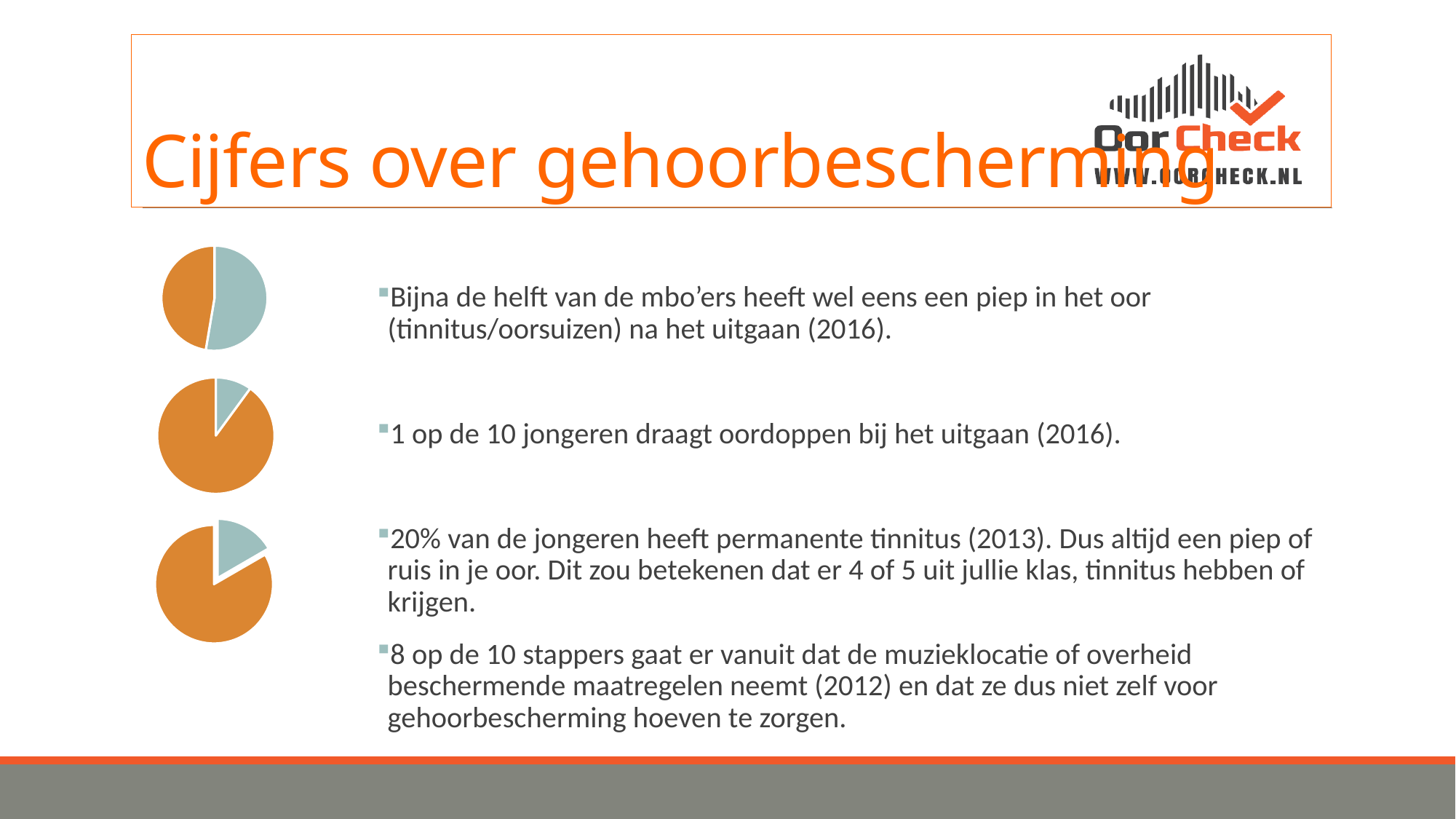
In the middle pie chart on the left, is the teal slice greater or less than half of the pie? less In the bottom pie chart on the left, which slice is larger, the orange one or the teal one? The orange one How many pie charts are shown on the slide? 3 How many slices does the bottom pie chart on the left have? 2 What two colours are used for the slices in the pie charts on the slide? Orange and teal What kind of chart is the top chart on the left side of the slide? Pie chart In the middle pie chart on the left, which slice is larger, the orange one or the teal one? The orange one In the bottom pie chart on the left, is the orange slice greater or less than half of the pie? greater How many slices does the middle pie chart on the left have? 2 Do the pie charts on the slide have a legend? No